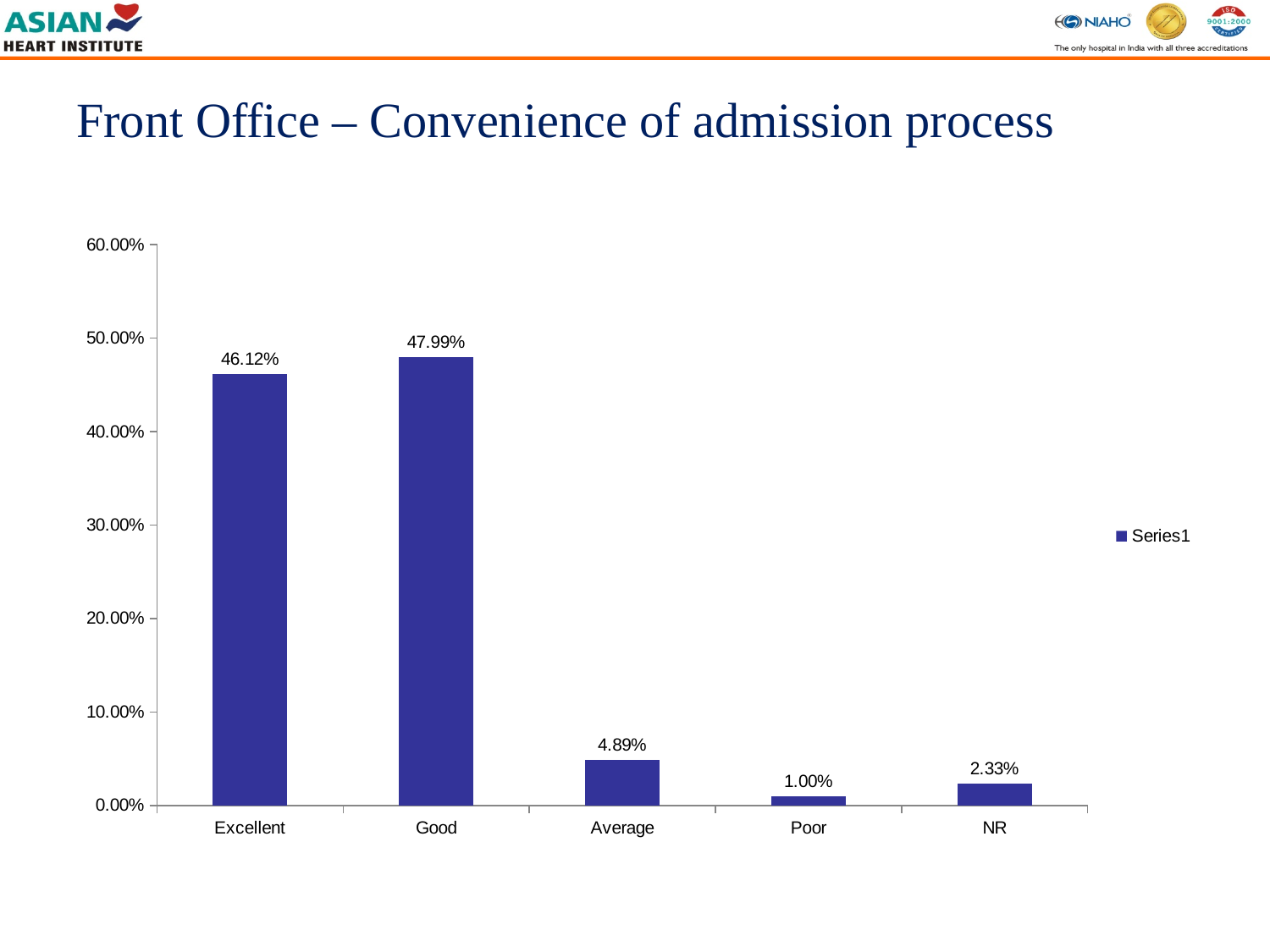
What is the value for Average? 4.89% What is the difference between the values for Good and Excellent? 1.87% How many categories are shown on the x axis? 5 What kind of chart is shown on the slide? bar chart What is the value for Excellent? 46.12% Which category has the lowest value? Poor What is the value for Poor? 1.00% What is the value for NR? 2.33% What is the value for Good? 47.99% Which category has the highest value? Good Is the value for Average greater or less than 10.00%? less Which is larger, the value for NR or the value for Poor? NR